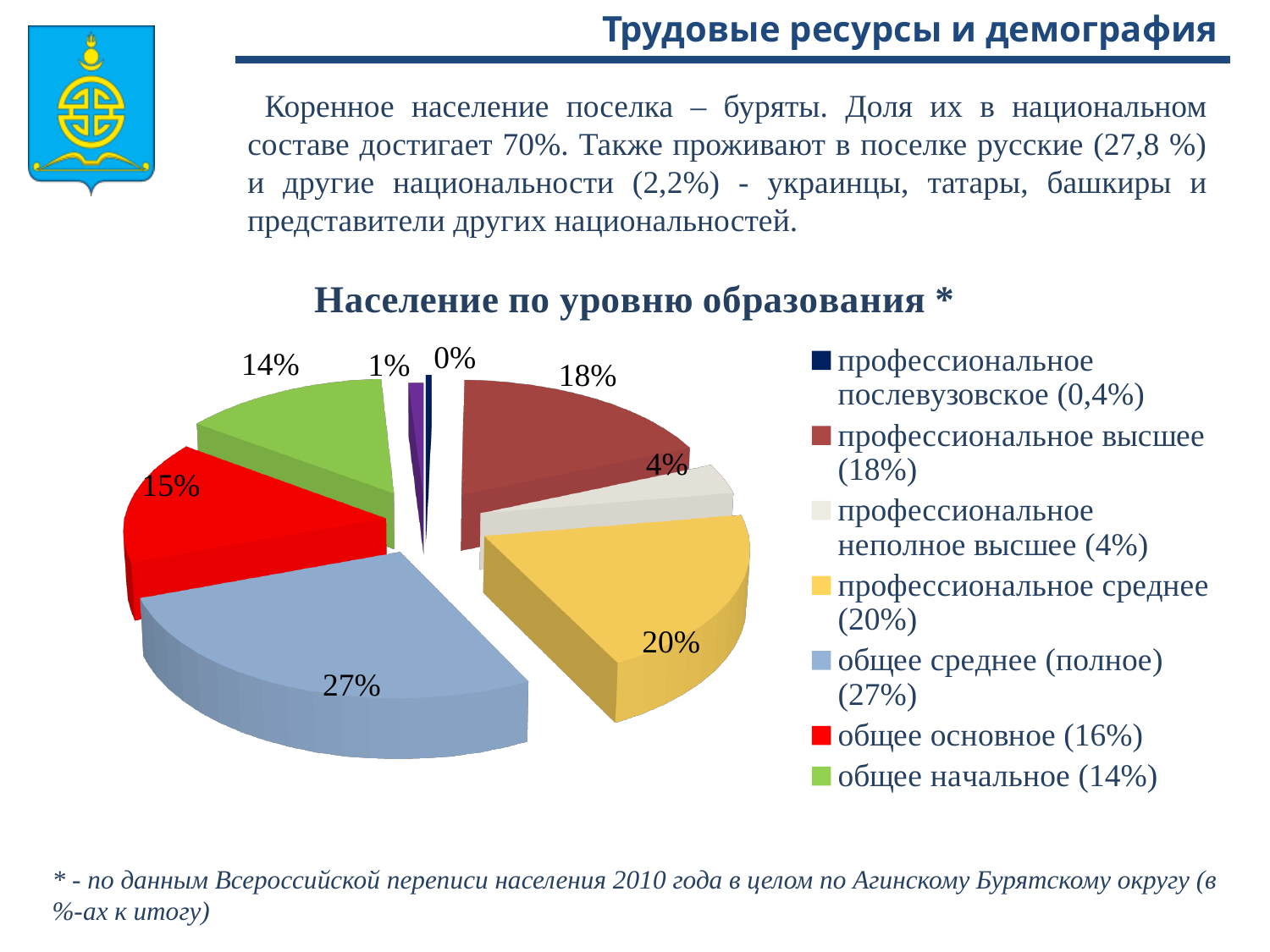
By how many percentage points does the общее среднее (полное) slice exceed the профессиональное высшее slice? 9 Which education level has the smallest slice in the pie chart? профессиональное послевузовское What share of the population has общее начальное education according to the pie chart? 14% What is the title of the pie chart on the slide? Население по уровню образования * What share of the population has профессиональное среднее education according to the pie chart? 20% Which education level has the largest slice in the pie chart? общее среднее (полное) What kind of chart is shown under the title "Население по уровню образования *"? pie chart What share of the population has профессиональное высшее education according to the pie chart? 18% How many entries does the legend of the pie chart list? 7 What share of the population has общее среднее (полное) education according to the pie chart? 27% What share of the population has профессиональное неполное высшее education according to the pie chart? 4% Which slice is larger in the pie chart: профессиональное высшее or профессиональное среднее? профессиональное среднее